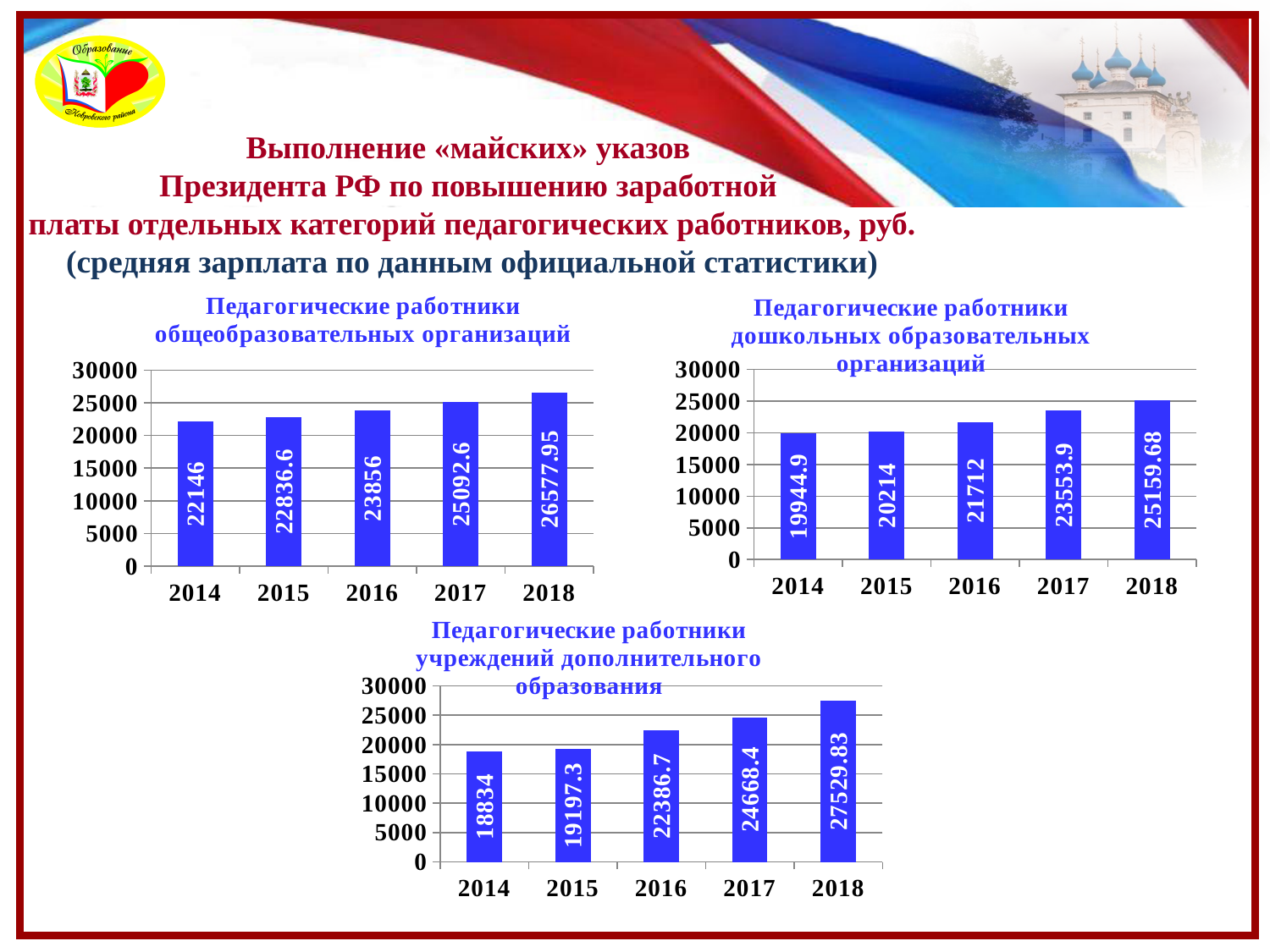
In the top-right chart (Педагогические работники дошкольных образовательных организаций), what is the difference between the 2016 and 2015 values? 1498 In the bottom chart (Педагогические работники учреждений дополнительного образования), do the values rise or fall from 2014 to 2018? rise In the top-left chart (Педагогические работники общеобразовательных организаций), what is the value for 2016? 23856 In the top-right chart (Педагогические работники дошкольных образовательных организаций), which year has the lowest value? 2014 In the bottom chart (Педагогические работники учреждений дополнительного образования), which is larger, the value for 2015 or the value for 2016? 2016 What kind of chart is the top-right chart (Педагогические работники дошкольных образовательных организаций)? bar chart How many years are shown on the x axis of the top-left chart (Педагогические работники общеобразовательных организаций)? 5 In the bottom chart (Педагогические работники учреждений дополнительного образования), what is the value for 2018? 27529.83 In the top-left chart (Педагогические работники общеобразовательных организаций), what is the difference between the 2018 and 2014 values? 4431.95 In the top-right chart (Педагогические работники дошкольных образовательных организаций), what is the value for 2017? 23553.9 In the top-left chart (Педагогические работники общеобразовательных организаций), which year has the highest value? 2018 In the bottom chart (Педагогические работники учреждений дополнительного образования), what is the difference between the 2017 and 2016 values? 2281.7